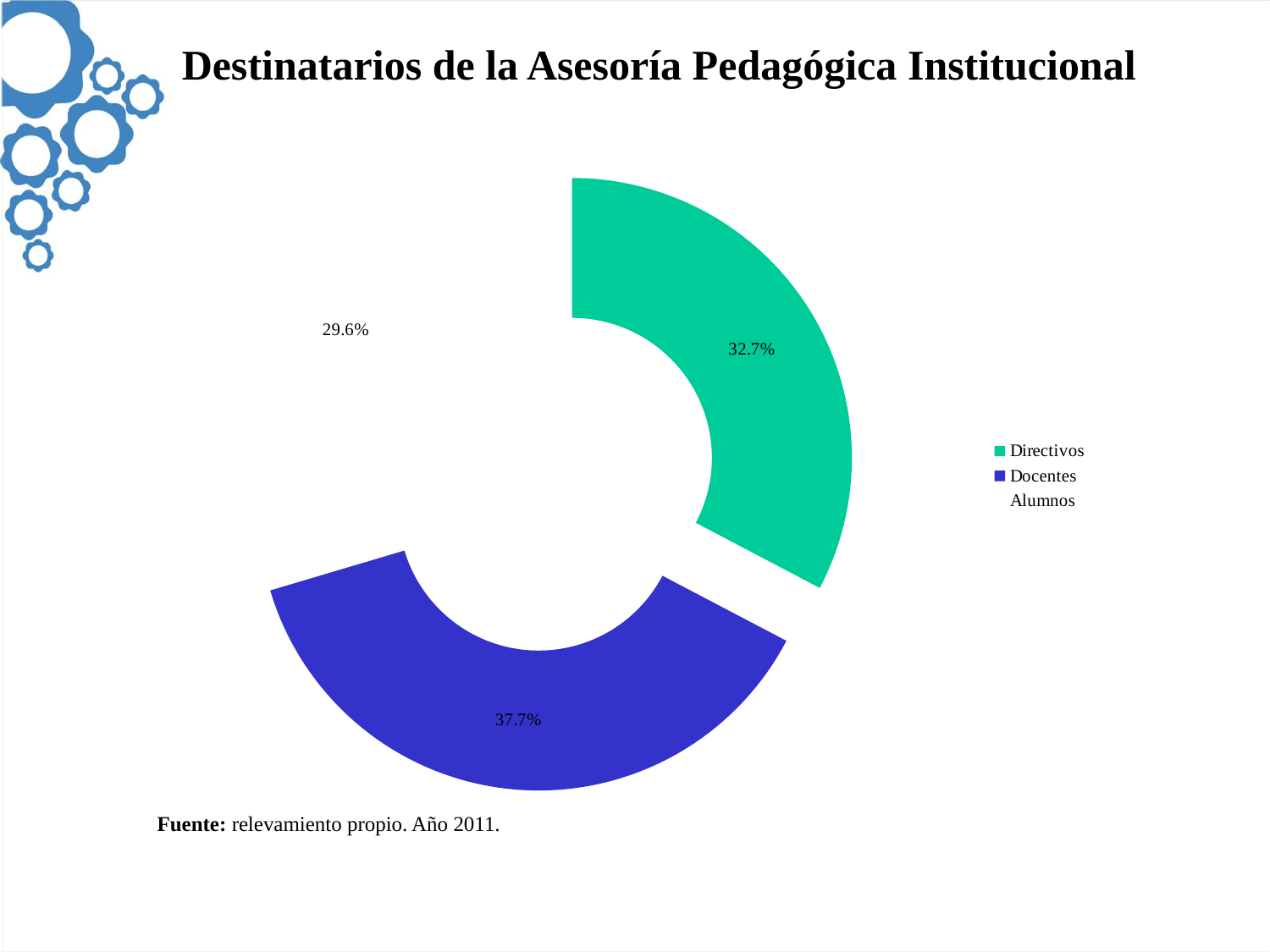
What percentage of the chart corresponds to Directivos? 32.7% What kind of chart is shown on the slide? doughnut chart What percentage of the chart corresponds to Docentes? 37.7% Which category has the smallest share of the chart? Alumnos According to the source note, in what year was the data collected? 2011 What is the difference in percentage points between the Directivos share and the Alumnos share? 3.1 percentage points How many categories does the chart show? 3 What is the title of the chart? Destinatarios de la Asesoría Pedagógica Institucional What is the difference in percentage points between the Docentes share and the Directivos share? 5.0 percentage points What percentage of the chart corresponds to Alumnos? 29.6% Which is larger, the share for Directivos or the share for Docentes? Docentes Which category has the largest share of the chart? Docentes